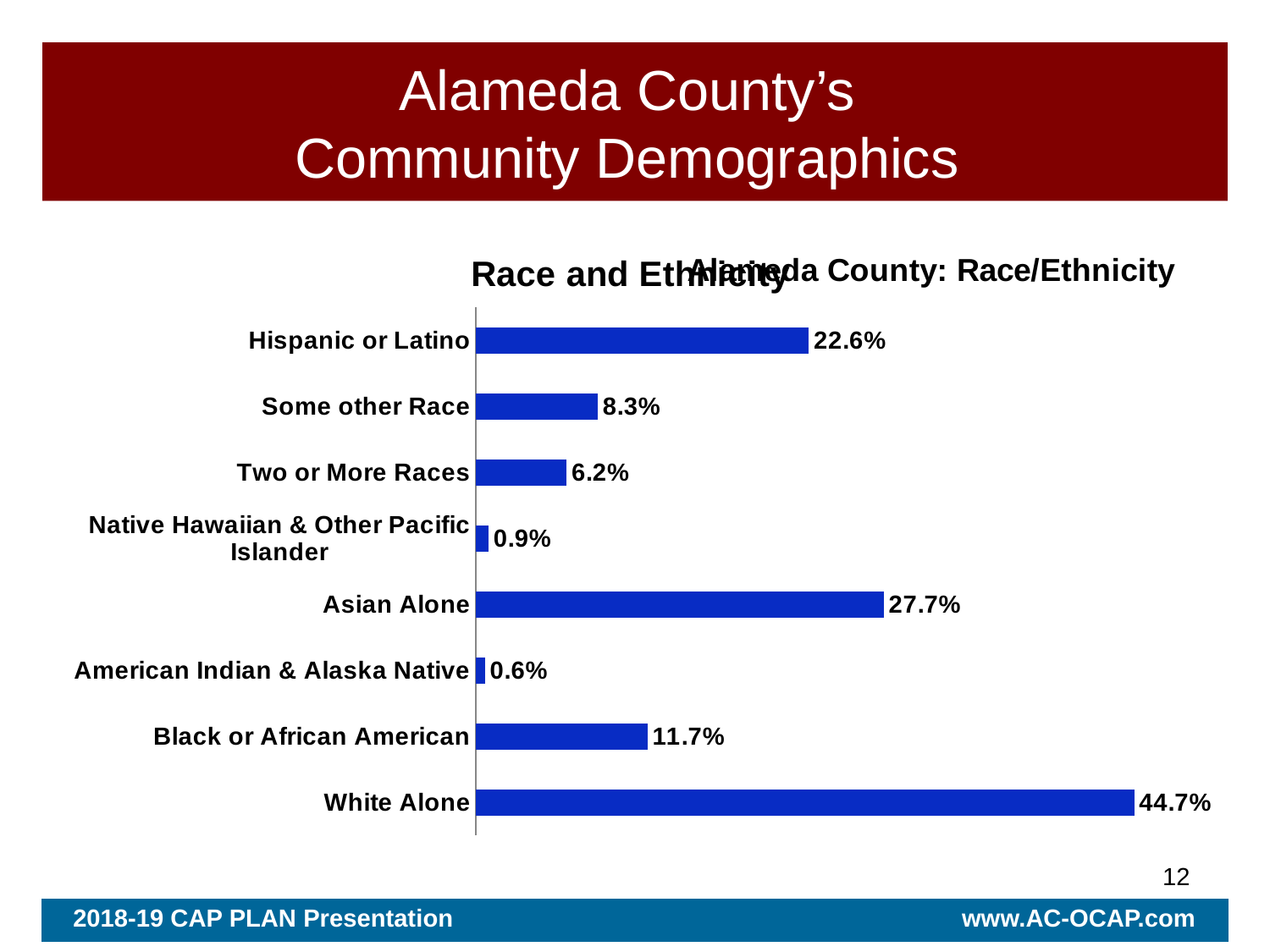
What is the difference between the values for Hispanic or Latino and Black or African American? 10.9 percentage points What kind of chart is shown on the slide? Bar chart Which category has the highest value? White Alone Which is larger, the value for Some other Race or the value for Two or More Races? Some other Race What is the difference between the values for White Alone and Asian Alone? 17.0 percentage points Which category has the lowest value? American Indian & Alaska Native What is the value for Hispanic or Latino? 22.6% What is the value for Asian Alone? 27.7% What is the value for Native Hawaiian & Other Pacific Islander? 0.9% What is the value for Black or African American? 11.7% What is the value for White Alone? 44.7% How many categories are shown in the chart? 8